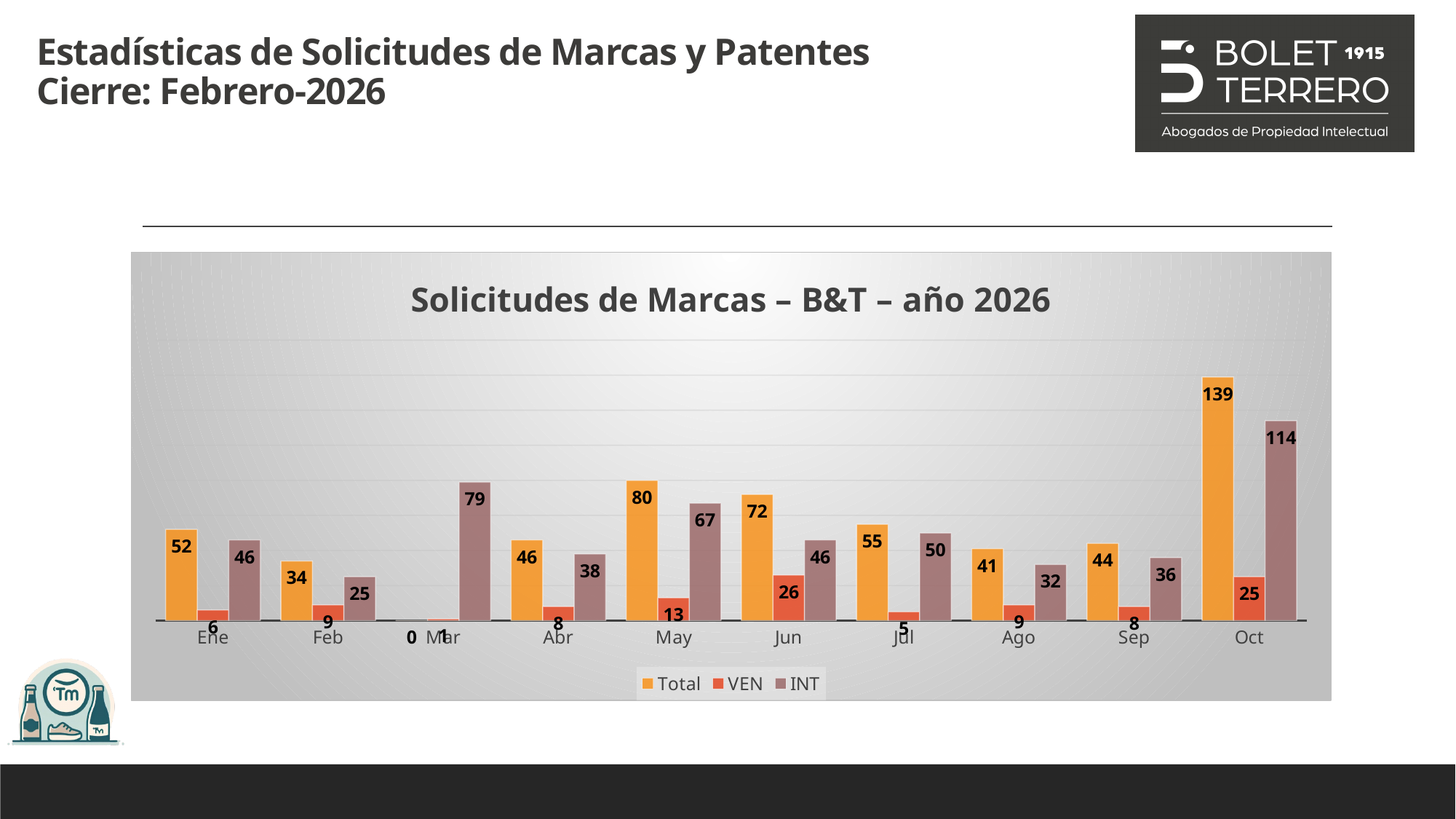
What is the title of the chart? Solicitudes de Marcas – B&T – año 2026 What is the VEN value for Jun? 26 Which is larger, the INT value for Jun or the INT value for Jul? Jul What kind of chart is shown? Bar chart What is the Total value for Oct? 139 How many months are shown on the x axis? 10 What is the INT value for May? 67 Which month has the highest Total value? Oct What is the difference between the Total values for Oct and May? 59 Which month has the lowest VEN value among Ene, Feb, Abr, May, Jun, Jul, Ago, Sep and Oct? Jul How many series does the legend list? 3 What is the difference between the Total and INT values for Ene? 6